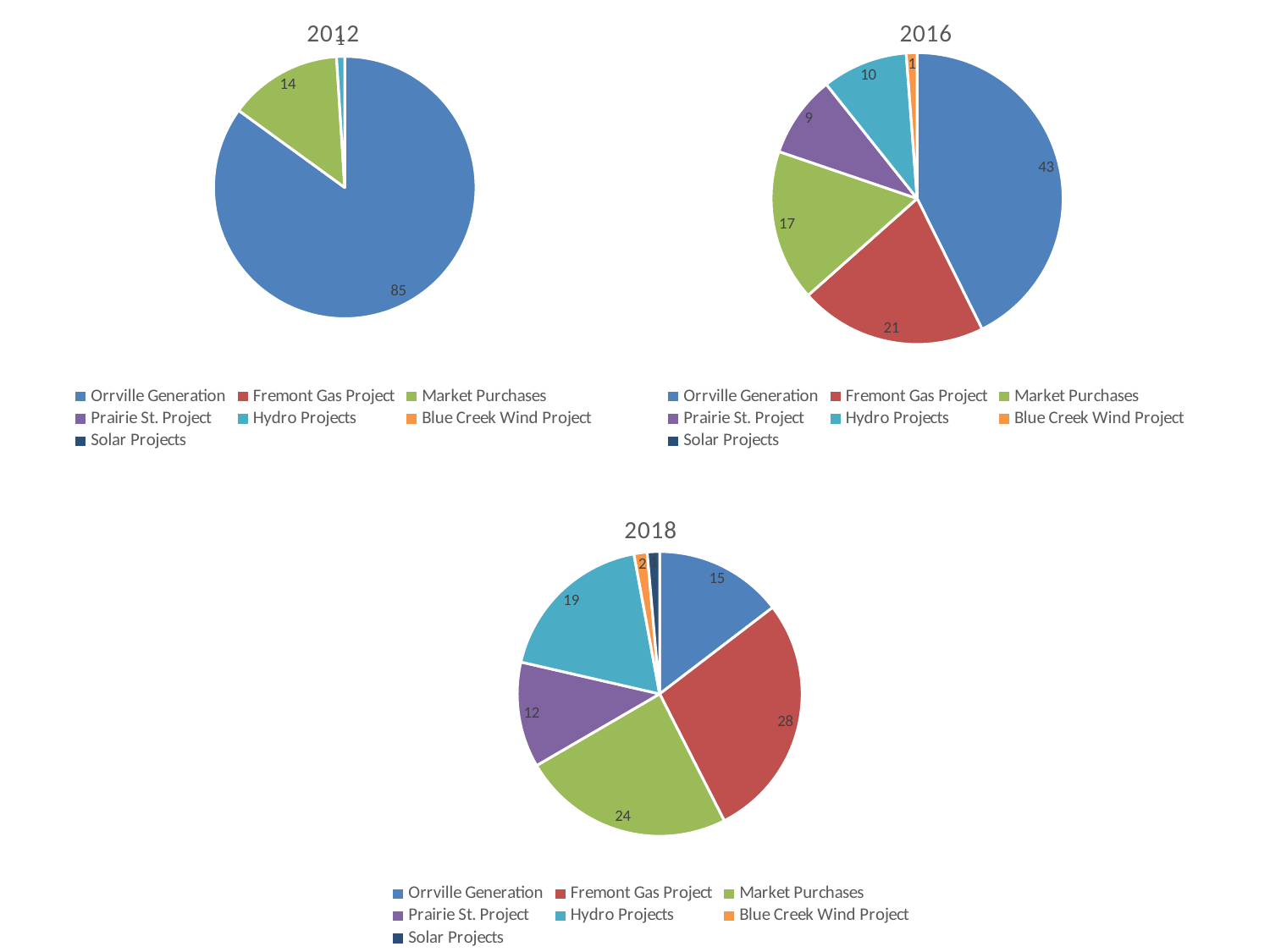
In the 2018 pie chart, which is larger, Market Purchases or Orrville Generation? Market Purchases In the 2016 pie chart, which category has the largest slice? Orrville Generation In the 2018 pie chart, what is the difference between Fremont Gas Project and Prairie St. Project? 16 In the 2018 pie chart, which category has the largest slice? Fremont Gas Project In the 2012 pie chart, what is the value for Orrville Generation? 85 In the 2012 pie chart, what is the value for Market Purchases? 14 In the 2018 pie chart, what is the value for Hydro Projects? 19 How many series does the legend of the 2018 chart list? 7 In the 2016 pie chart, which is larger, Hydro Projects or Prairie St. Project? Hydro Projects In the 2016 pie chart, what is the value for Fremont Gas Project? 21 In the 2016 pie chart, what is the difference between Market Purchases and Prairie St. Project? 8 What kind of chart is the 2012 chart? Pie chart